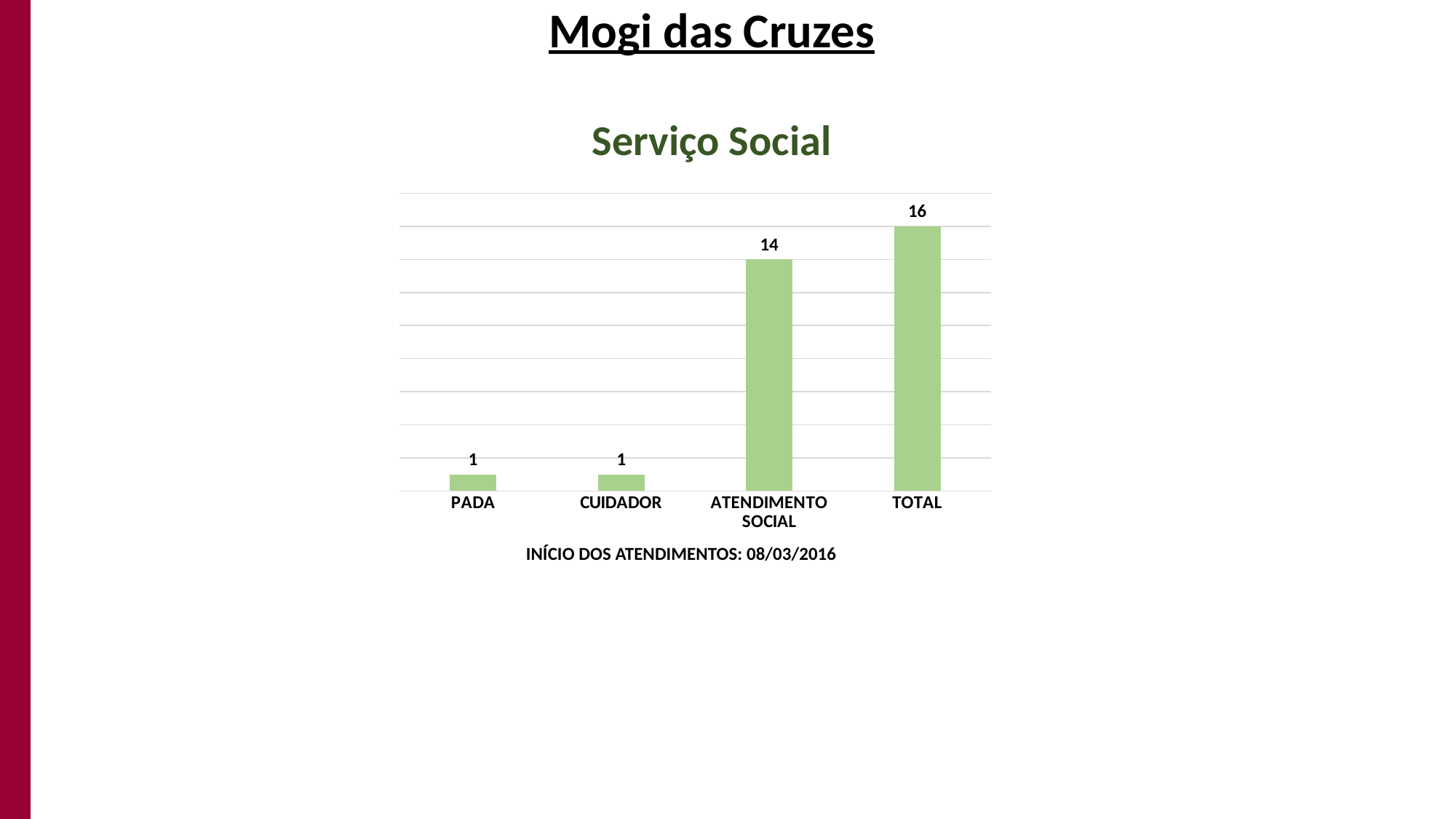
Which is larger, the value for ATENDIMENTO SOCIAL or the value for CUIDADOR? ATENDIMENTO SOCIAL Which category has the highest value? TOTAL What is the difference between the values for ATENDIMENTO SOCIAL and PADA? 13 What is the title of the chart? Serviço Social What kind of chart is shown on the slide? bar chart What date is given as the start of the atendimentos below the chart? 08/03/2016 What is the value for PADA? 1 What is the value for CUIDADOR? 1 What is the value for TOTAL? 16 What is the difference between the values for TOTAL and ATENDIMENTO SOCIAL? 2 How many categories are shown on the x axis? 4 What is the value for ATENDIMENTO SOCIAL? 14